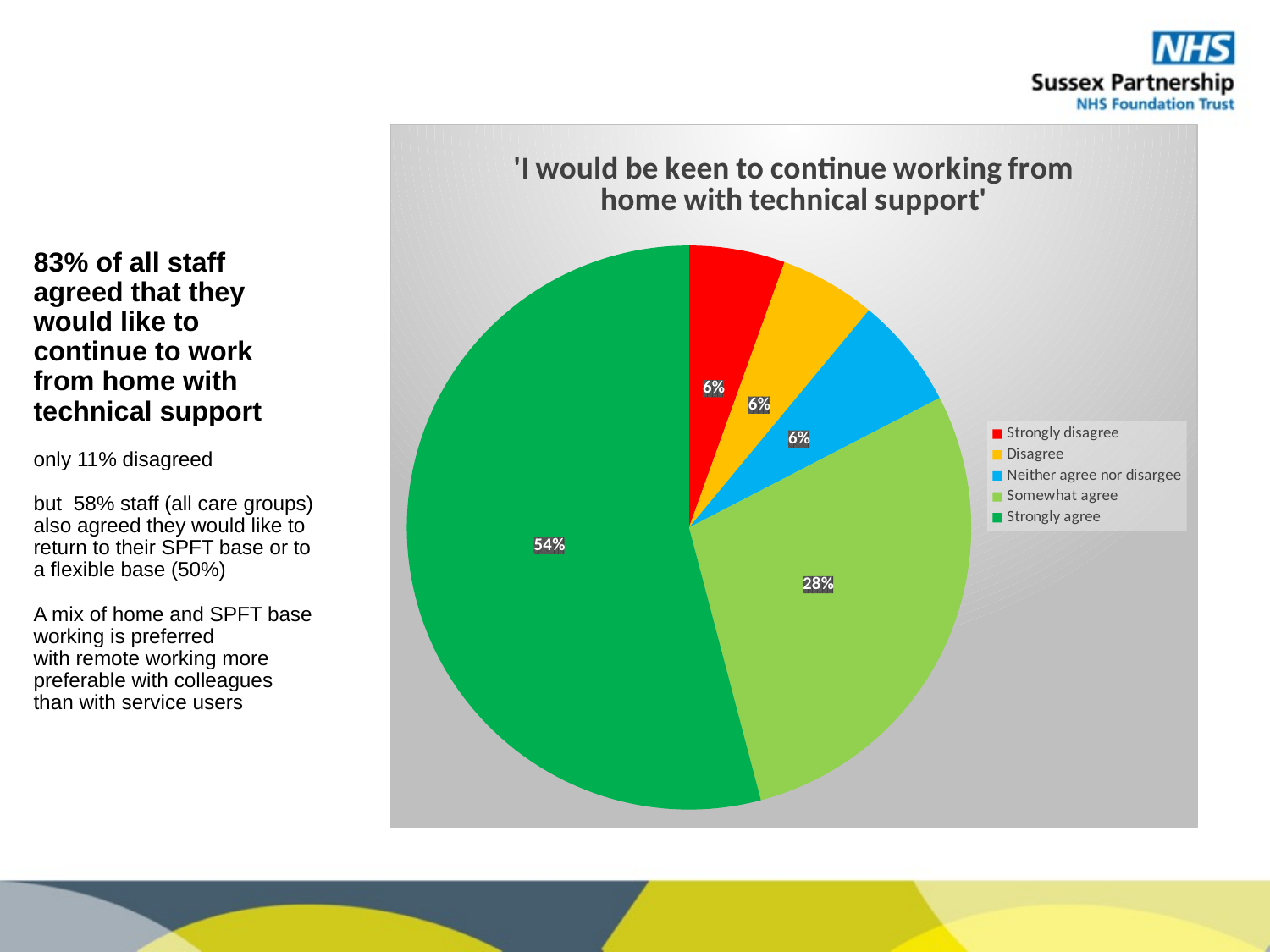
What is the combined share of 'Strongly agree' and 'Somewhat agree'? 82% What is the difference between the 'Strongly agree' and 'Somewhat agree' shares? 26% What colour is the 'Strongly disagree' slice? Red How many categories does the legend list? 5 Which category has the largest slice of the pie? Strongly agree What share of the pie is 'Neither agree nor disargee'? 6% What share of the pie is 'Strongly disagree'? 6% What is the title of the chart? 'I would be keen to continue working from home with technical support' Which is larger, the 'Somewhat agree' slice or the 'Disagree' slice? Somewhat agree What share of the pie is 'Strongly agree'? 54% What kind of chart is shown on the slide? Pie chart